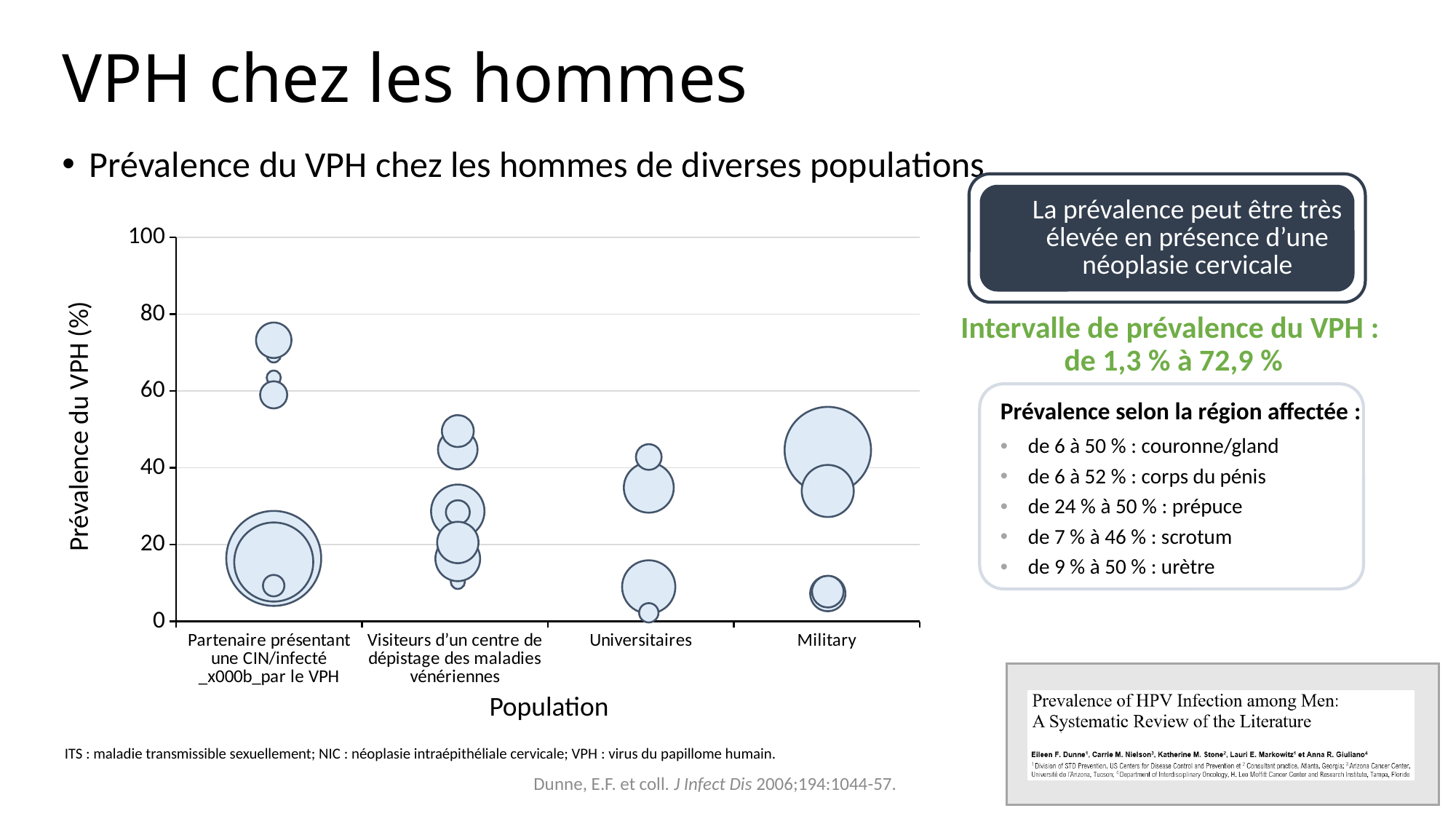
How many population categories are shown on the x axis of the chart? 4 What kind of chart is shown on the slide? Bubble chart Is the lowest bubble for 'Universitaires' greater or less than 20? less Which population category contains the bubble with the lowest VPH prevalence? Universitaires What is the label of the y axis of the chart? Prévalence du VPH (%) Is the highest bubble for 'Military' greater or less than 60? less Is the lowest bubble for 'Military' greater or less than 20? less Which population category contains the bubble with the highest VPH prevalence? Partenaire présentant une CIN/infecté par le VPH Which is higher: the highest bubble for 'Partenaire présentant une CIN/infecté par le VPH' or the highest bubble for 'Universitaires'? Partenaire présentant une CIN/infecté par le VPH What is the label of the x axis of the chart? Population